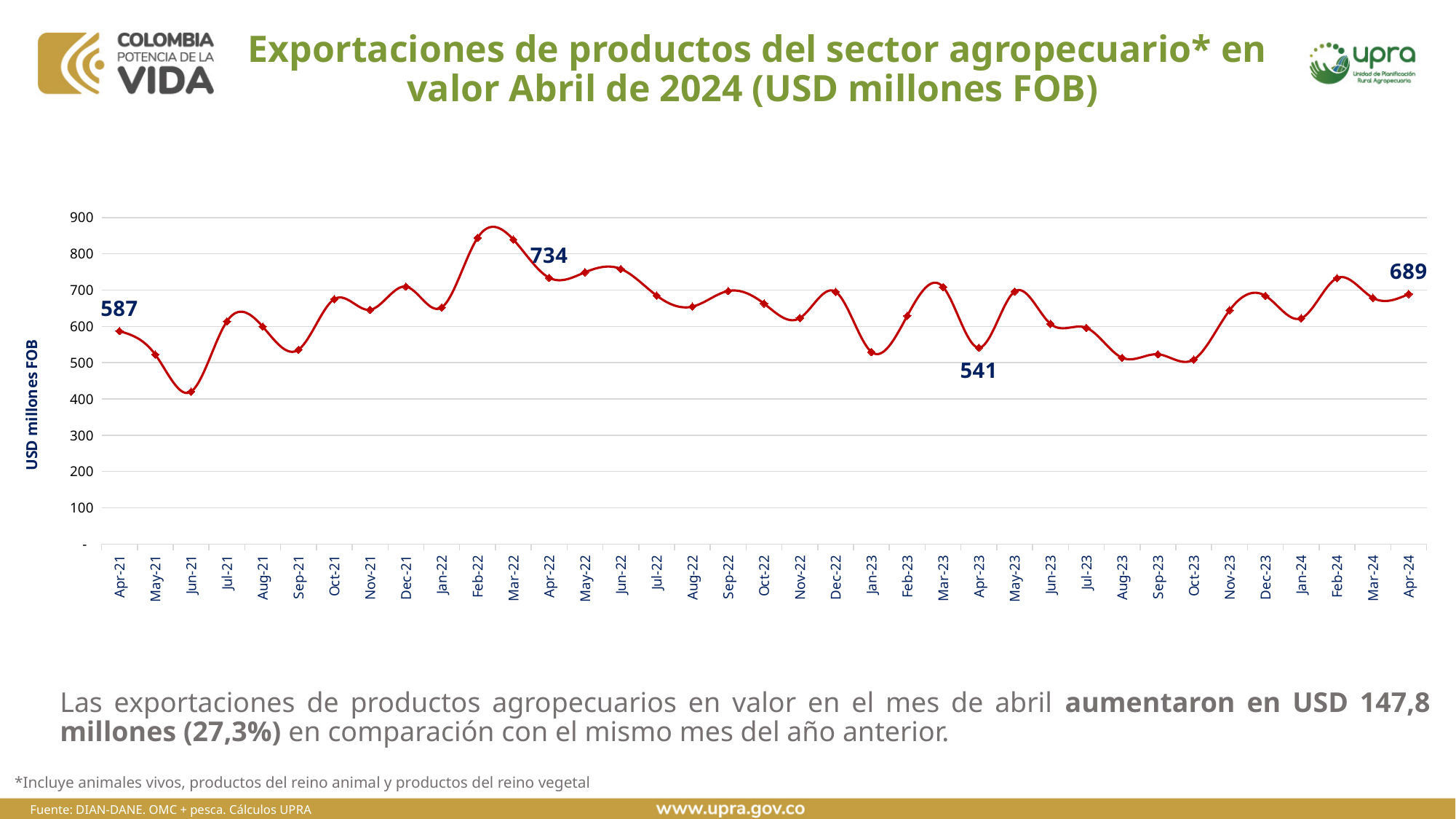
What is the value for Apr-23? 541 Is the value for Jun-21 greater or less than 500? less What is the difference between the values for Apr-24 and Apr-23? 148 What is the value for Apr-24? 689 What is the value for Apr-21? 587 Which month has the lowest value on the chart? Jun-21 What is the value for Apr-22? 734 What kind of chart is shown on the slide? line chart Which is larger, the value for Apr-22 or the value for Apr-24? Apr-22 What is the difference between the values for Apr-22 and Apr-21? 147 How many monthly data points are plotted on the chart? 37 What is the title of the vertical axis? USD millones FOB